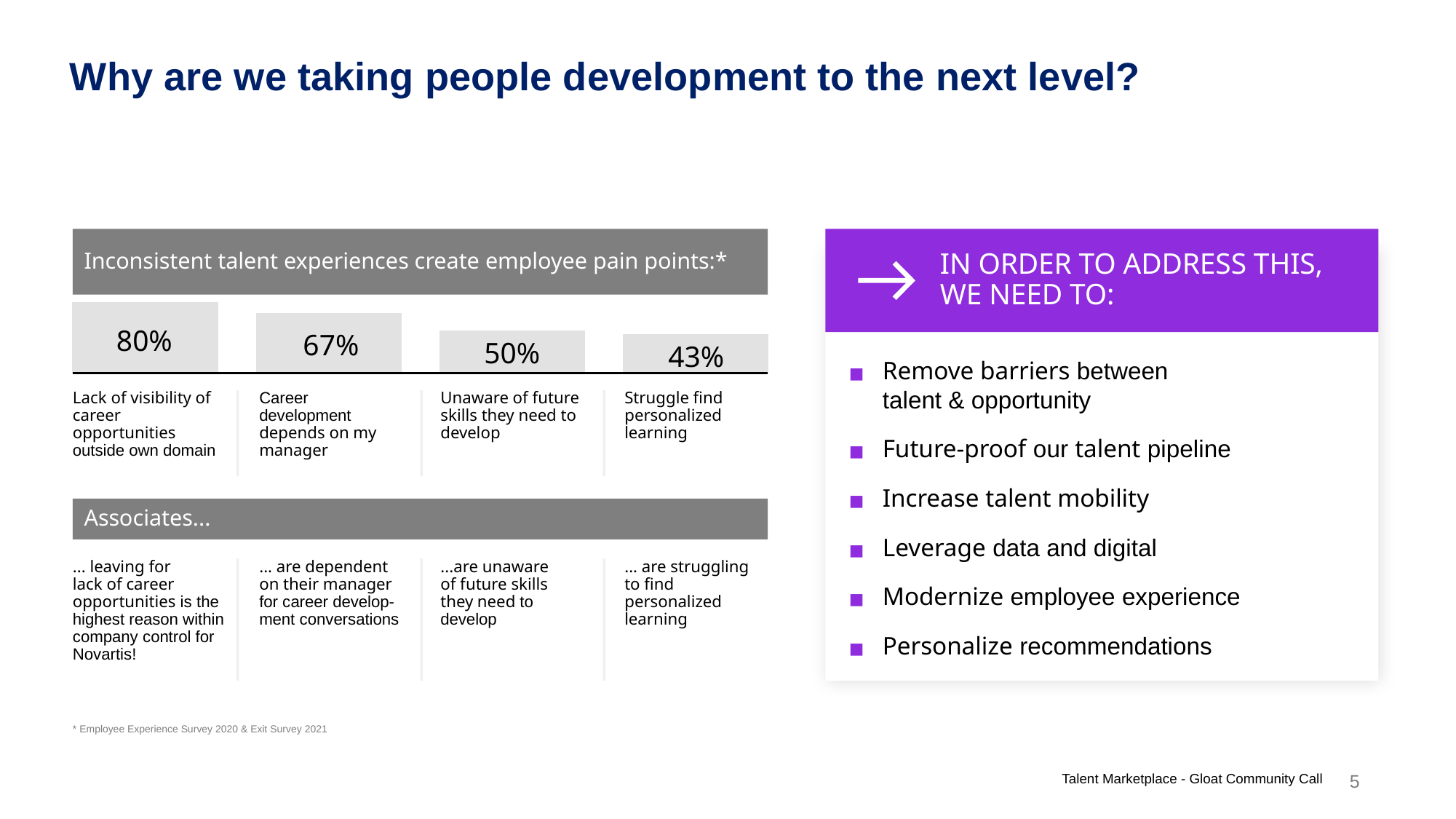
What is the difference between the percentage for "Career development depends on my manager" and "Unaware of future skills they need to develop"? 17% Which pain point has the lowest percentage? Struggle find personalized learning Do the percentages rise or fall from left to right across the chart? fall Which is larger: the percentage for "Career development depends on my manager" or for "Unaware of future skills they need to develop"? Career development depends on my manager What is the heading above the percentage chart? Inconsistent talent experiences create employee pain points:* What percentage is shown for "Lack of visibility of career opportunities outside own domain"? 80% What percentage is shown for "Career development depends on my manager"? 67% What percentage is shown for "Struggle find personalized learning"? 43% How many pain points are shown with percentages in the chart? 4 What percentage is shown for "Unaware of future skills they need to develop"? 50% Which pain point has the highest percentage? Lack of visibility of career opportunities outside own domain What is the difference between the percentage for "Lack of visibility of career opportunities outside own domain" and "Struggle find personalized learning"? 37%